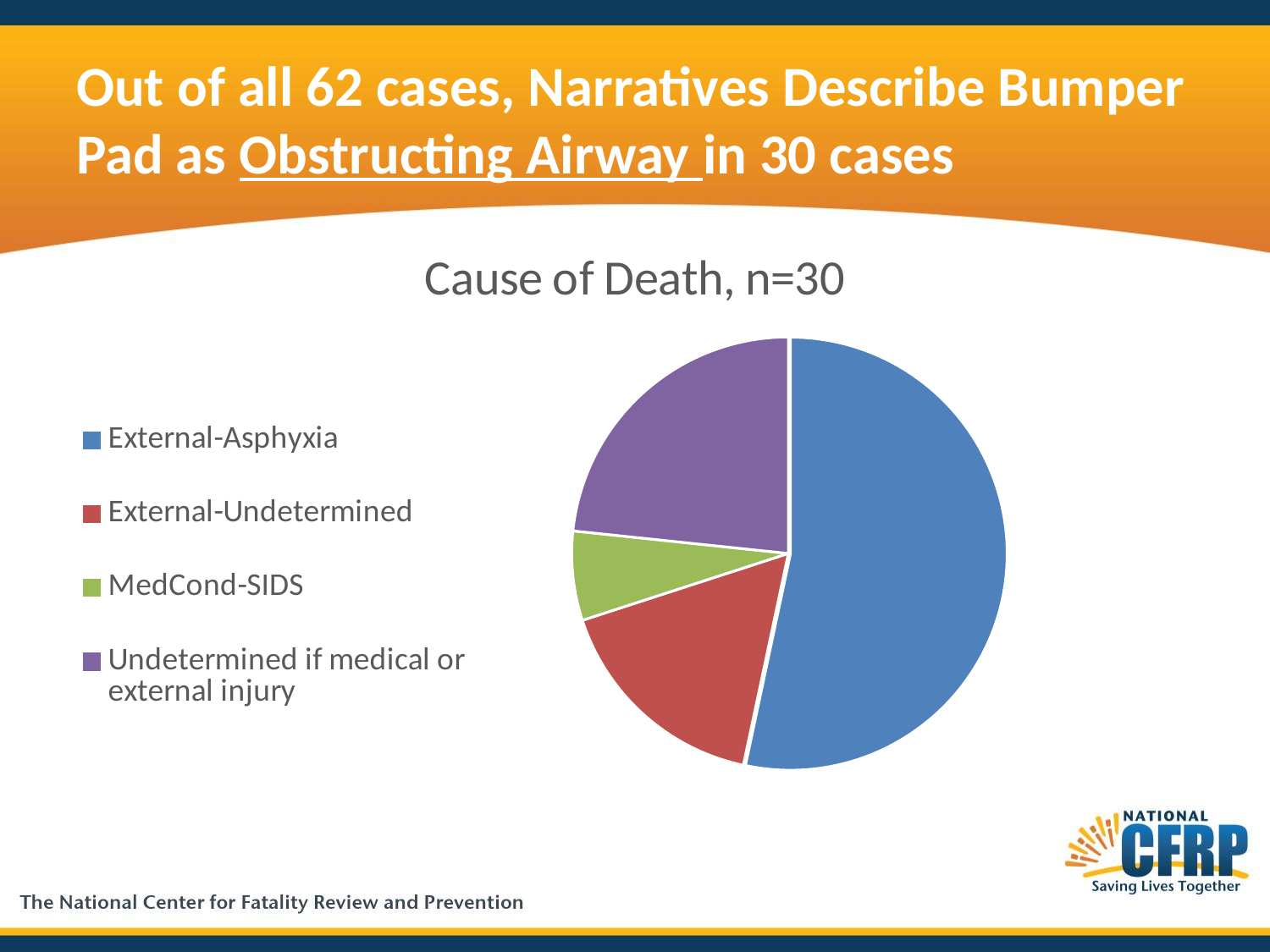
How many categories does the pie chart show? 4 Which slice is larger: External-Undetermined or MedCond-SIDS? External-Undetermined What colour is the slice for MedCond-SIDS? green Which cause of death has the largest slice of the pie? External-Asphyxia Which slice is larger: Undetermined if medical or external injury or External-Undetermined? Undetermined if medical or external injury How many entries does the legend list? 4 What is the title of the chart? Cause of Death, n=30 What kind of chart is shown on the slide? pie chart Which slice is larger: External-Asphyxia or Undetermined if medical or external injury? External-Asphyxia Which cause of death has the smallest slice of the pie? MedCond-SIDS